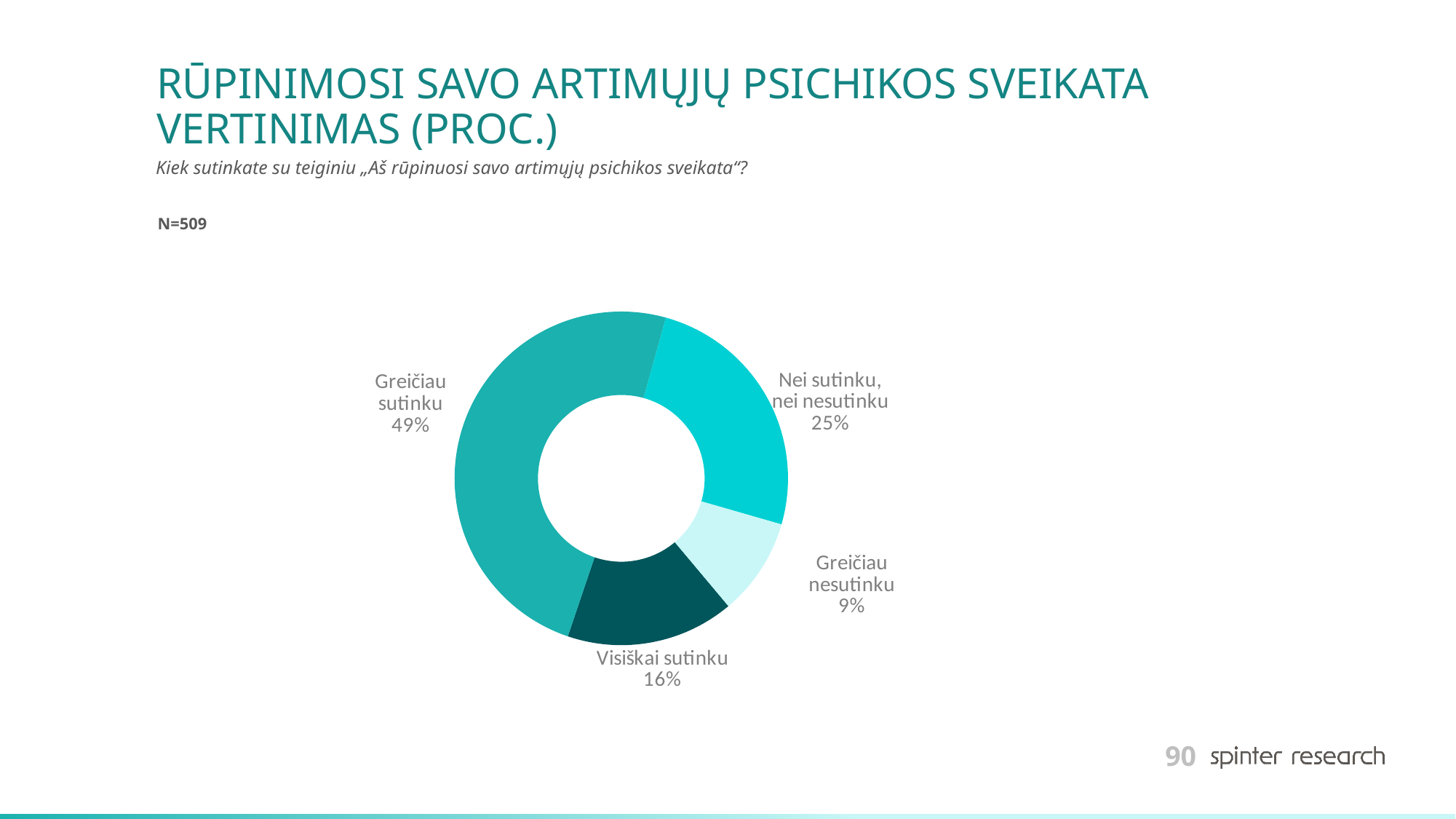
What share is shown for "Nei sutinku, nei nesutinku"? 25% What sample size (N) is stated on the slide? N=509 Which response category has the largest share of the chart? Greičiau sutinku What percentage of respondents answered "Greičiau sutinku"? 49% What is the difference in percentage points between "Greičiau sutinku" and "Nei sutinku, nei nesutinku"? 24 What is the difference in percentage points between "Visiškai sutinku" and "Greičiau nesutinku"? 7 What share is shown for "Greičiau nesutinku"? 9% Which is larger: the share for "Visiškai sutinku" or the share for "Nei sutinku, nei nesutinku"? Nei sutinku, nei nesutinku What type of chart is shown on the slide? Doughnut (pie) chart How many response categories are shown in the chart? 4 What percentage of respondents answered "Visiškai sutinku"? 16% Which response category has the smallest share of the chart? Greičiau nesutinku